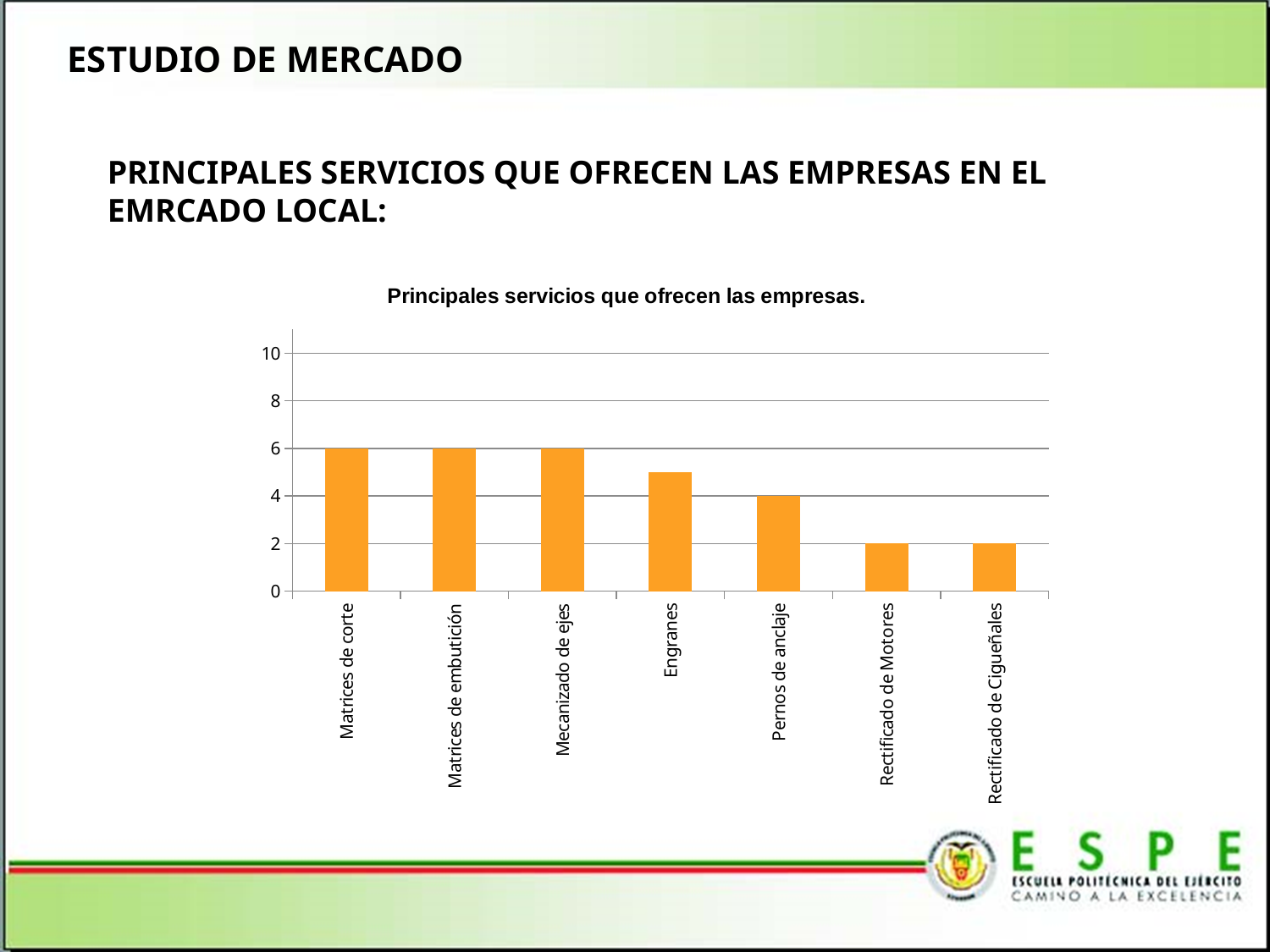
What is the value for Rectificado de Motores? 2 How many categories are shown on the x axis? 7 What kind of chart is shown on the slide? Bar chart What is the value for Pernos de anclaje? 4 Is the value for Engranes greater or less than 4? greater Which is larger, the value for Matrices de embutición or the value for Pernos de anclaje? Matrices de embutición What is the value for Mecanizado de ejes? 6 Do the values rise or fall from left to right along the x axis? Fall Is the value for Engranes greater or less than 6? less What is the title of the chart? Principales servicios que ofrecen las empresas. What is the difference between the value for Matrices de corte and the value for Rectificado de Cigueñales? 4 What is the value for Matrices de corte? 6